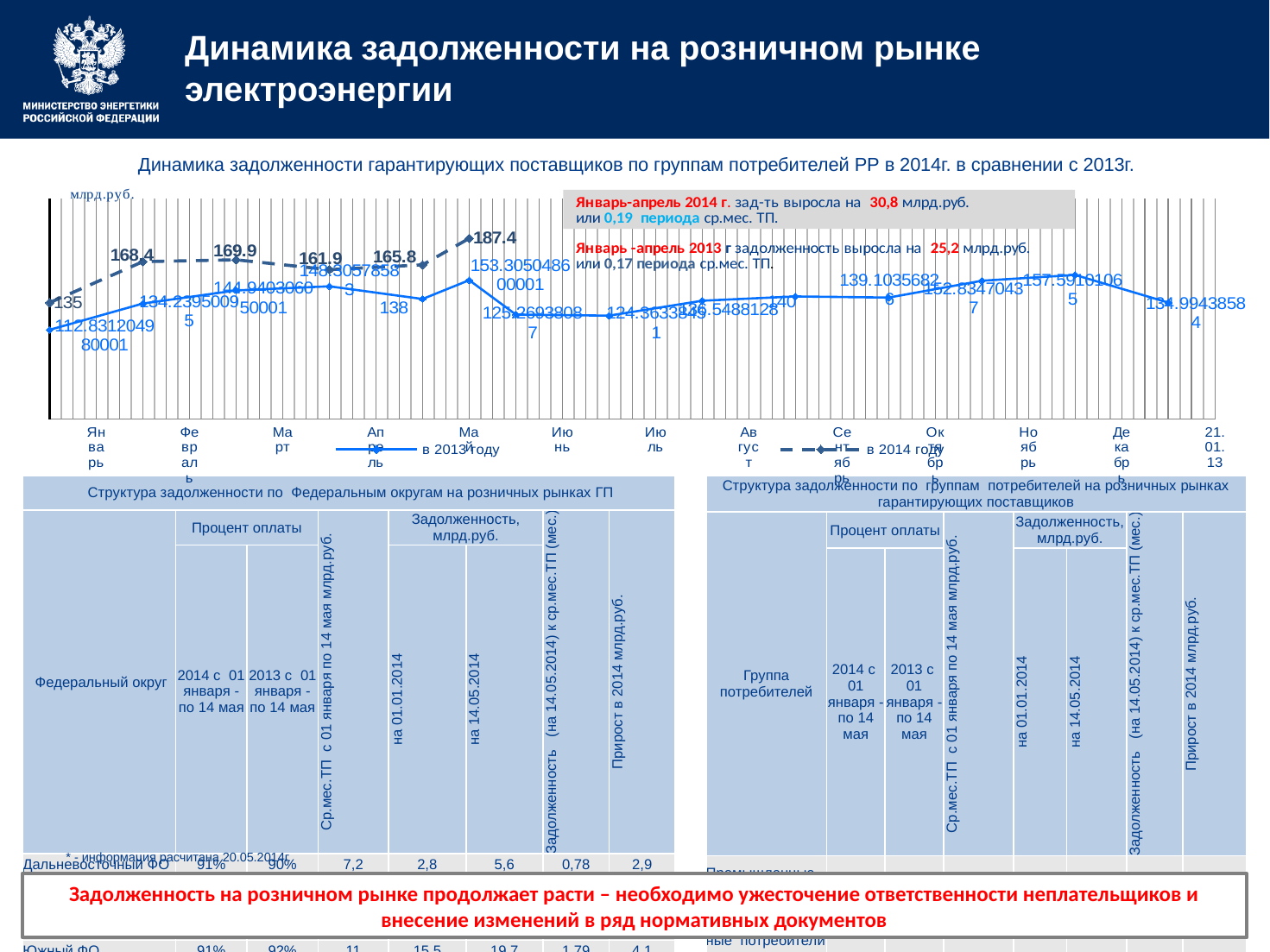
What is the highest labelled value of the 2014 series (dashed line)? 187.4 What kind of chart is shown on the slide? line chart According to the text box on the chart, by how much did debt grow in January-April 2014? 30,8 млрд.руб. What is the lowest labelled value of the 2014 series (dashed line)? 135 What is the difference between the 2014 series values 187.4 and 165.8? 21.6 Does the 2014 series (dashed line) overall rise or fall from its first point to its last point? rise How many series does the chart legend list? 2 What is the second labelled value of the 2014 series (dashed line)? 168.4 What is the third labelled value of the 2014 series (dashed line)? 169.9 Which is larger on the 2014 series: the value 161.9 or the value 165.8? 165.8 What are the two series named in the chart legend? в 2013 году and в 2014 году What is the difference between the 2014 series values 169.9 and 168.4? 1.5